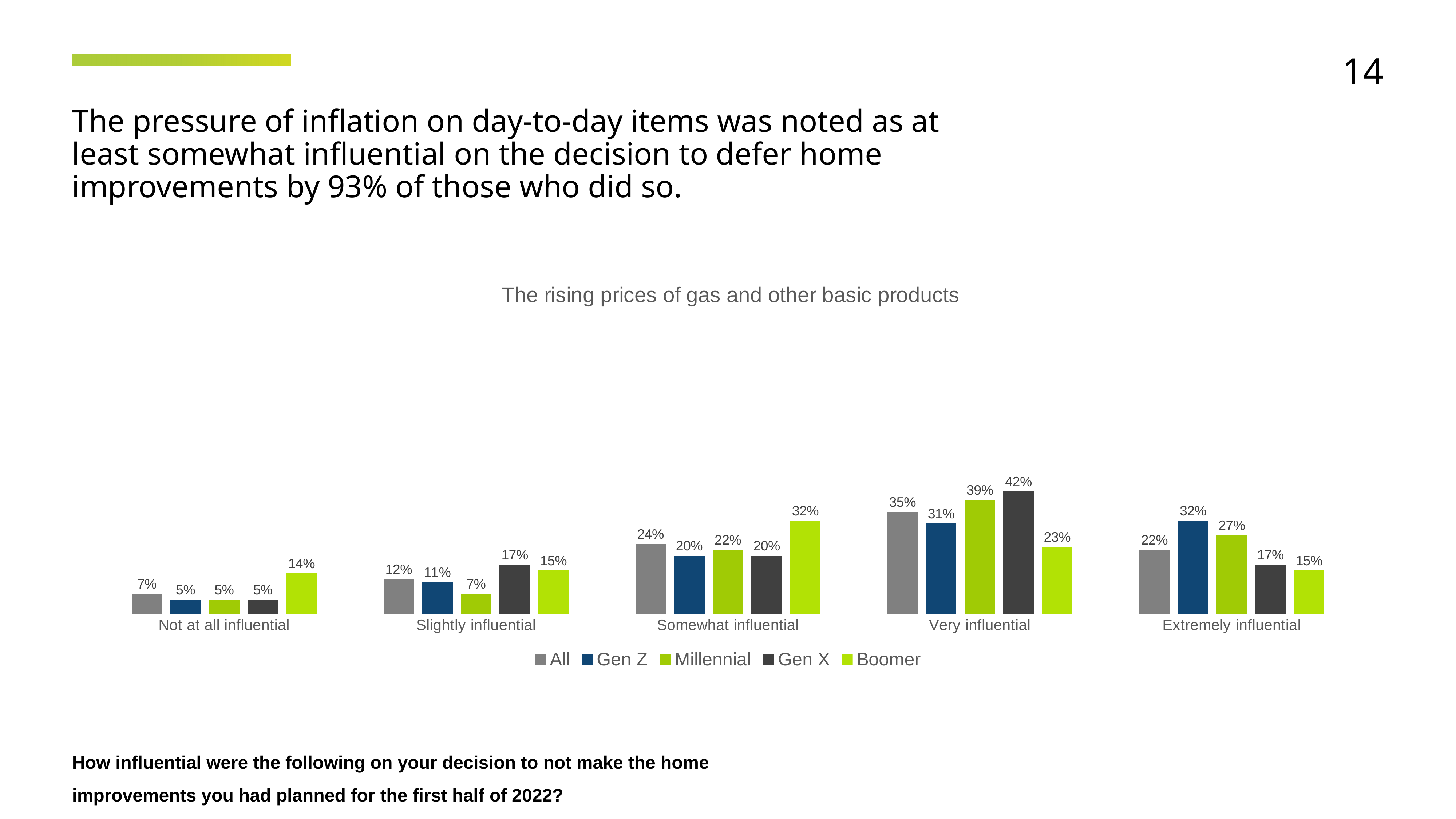
What is the value for Boomer in the Not at all influential category? 14% What is the value for Gen X in the Very influential category? 42% Which series has the lowest value in the Slightly influential category? Millennial How many series does the legend list? 5 Which series has the highest value in the Very influential category? Gen X What is the difference between the Millennial and Boomer values in the Very influential category? 16% What is the value for All in the Somewhat influential category? 24% How many categories are shown on the x axis? 5 Which is larger in the Extremely influential category: the value for Gen Z or the value for Millennial? Gen Z What kind of chart is shown on the slide? Bar chart What is the title of the chart? The rising prices of gas and other basic products What is the value for Gen Z in the Extremely influential category? 32%